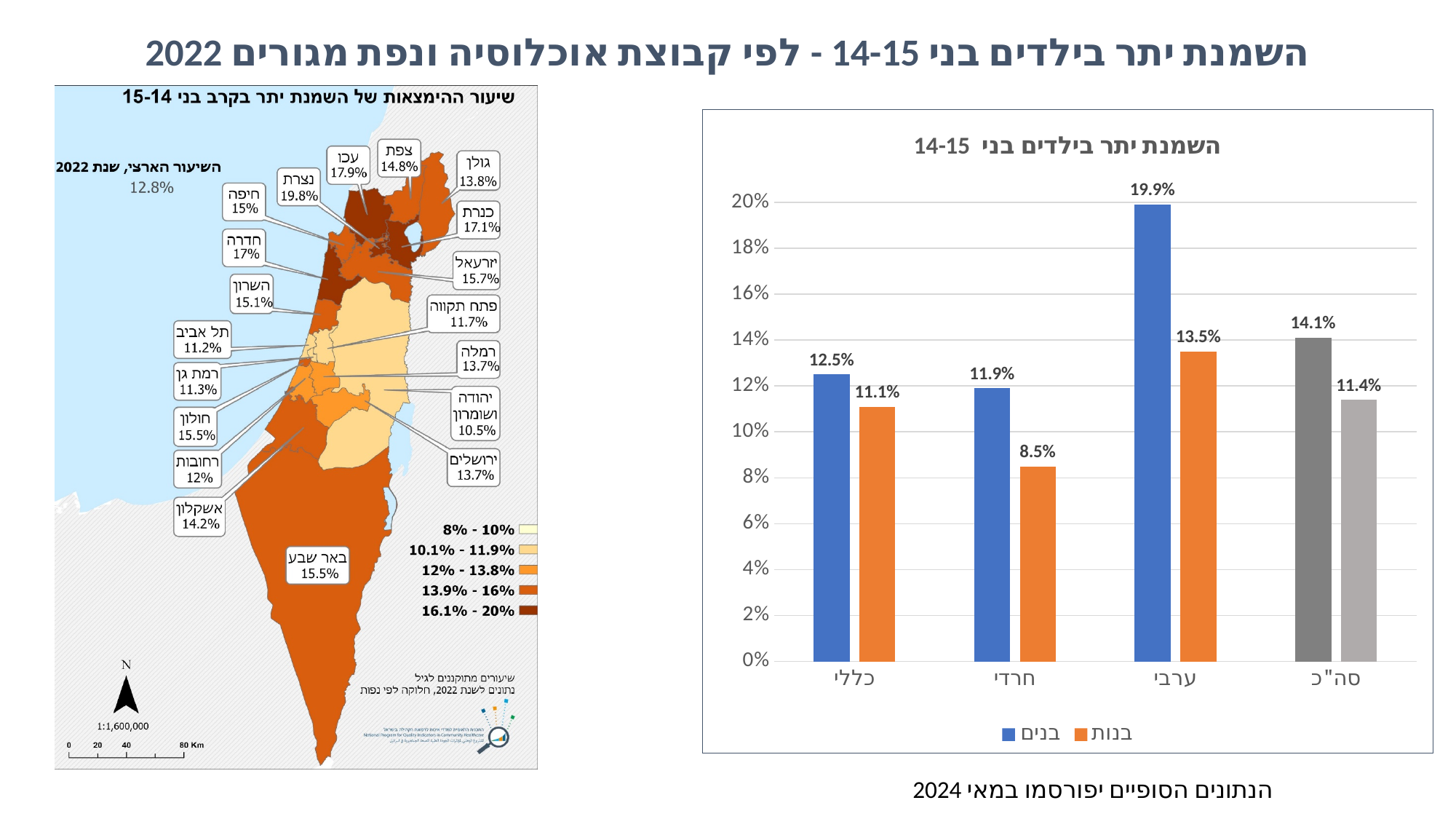
In the bar chart, what is the difference between the בנים and בנות values in the ערבי category? 6.4% In the bar chart, how many categories are shown on the x axis? 4 In the bar chart, what is the value for בנות in the כללי category? 11.1% In the bar chart, which colour represents the בנות series? orange In the bar chart, what is the value for בנים in the ערבי category? 19.9% In the bar chart, which category has the lowest value for בנות? חרדי In the bar chart, what is the value for בנים in the סה"כ category? 14.1% In the bar chart, what is the value for בנות in the חרדי category? 8.5% In the bar chart, how many series does the legend list? 2 In the bar chart, which is larger: the בנים value for כללי or the בנים value for חרדי? כללי In the bar chart, which category has the highest value for בנים? ערבי What kind of chart is shown on the right side of the slide? bar chart